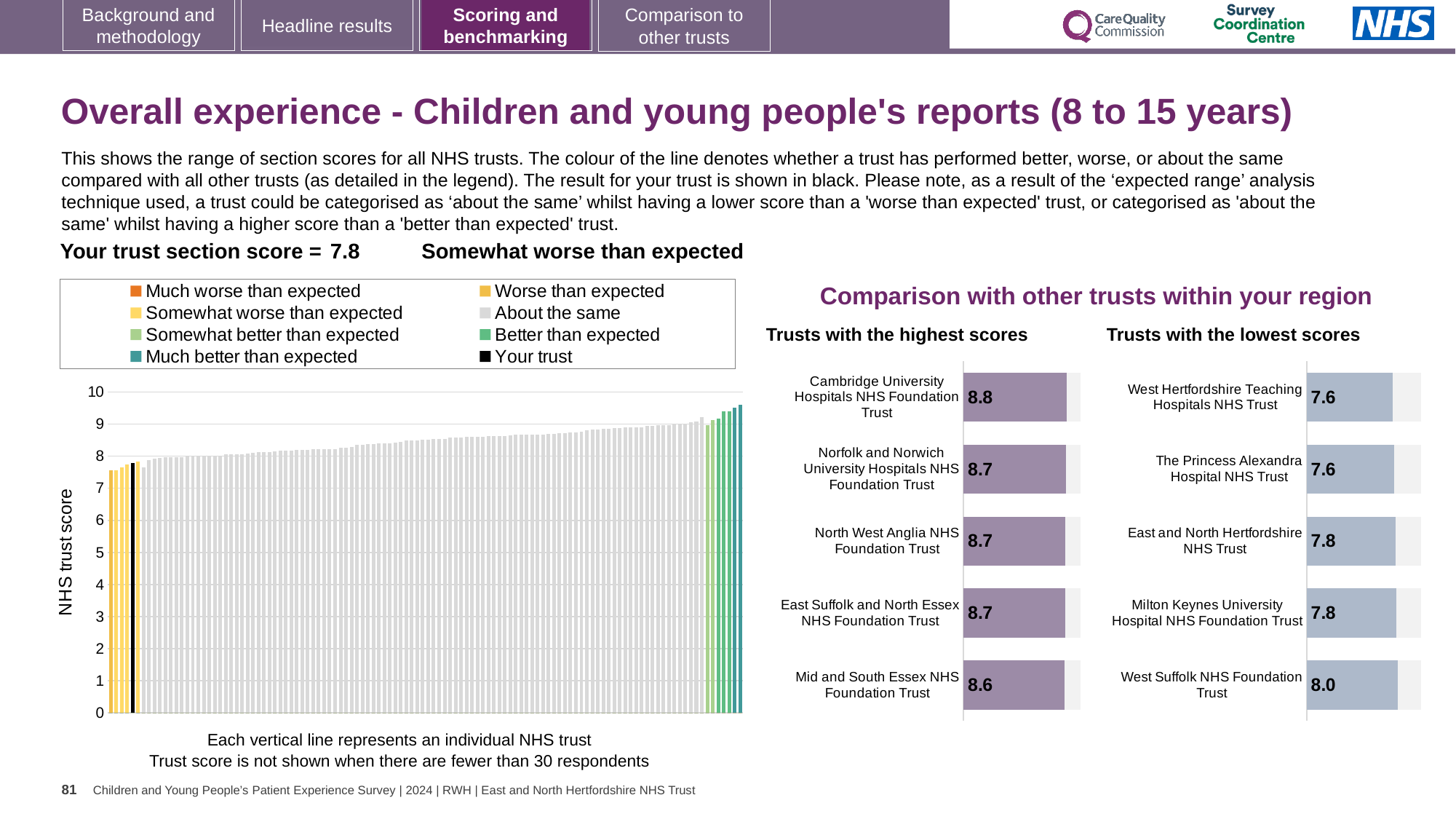
How many trusts are shown in the 'Trusts with the highest scores' chart? 5 How many entries does the legend of the left-hand chart list? 8 In the 'Trusts with the highest scores' chart, what is the score for Cambridge University Hospitals NHS Foundation Trust? 8.8 What kind of chart is the large chart on the left showing the range of NHS trust scores? Bar chart In the 'Trusts with the lowest scores' chart, which trust has the highest score? West Suffolk NHS Foundation Trust In the 'Trusts with the lowest scores' chart, what is the difference between the scores of West Suffolk NHS Foundation Trust and West Hertfordshire Teaching Hospitals NHS Trust? 0.4 In the 'Trusts with the lowest scores' chart, what is the score for Milton Keynes University Hospital NHS Foundation Trust? 7.8 In the 'Trusts with the lowest scores' chart, what is the score for West Suffolk NHS Foundation Trust? 8.0 What is the y-axis label of the left-hand chart? NHS trust score In the 'Trusts with the highest scores' chart, which trust has the lowest score? Mid and South Essex NHS Foundation Trust In the 'Trusts with the highest scores' chart, what is the difference between the scores of Cambridge University Hospitals NHS Foundation Trust and Mid and South Essex NHS Foundation Trust? 0.2 In the 'Trusts with the lowest scores' chart, which has the larger score: West Suffolk NHS Foundation Trust or East and North Hertfordshire NHS Trust? West Suffolk NHS Foundation Trust